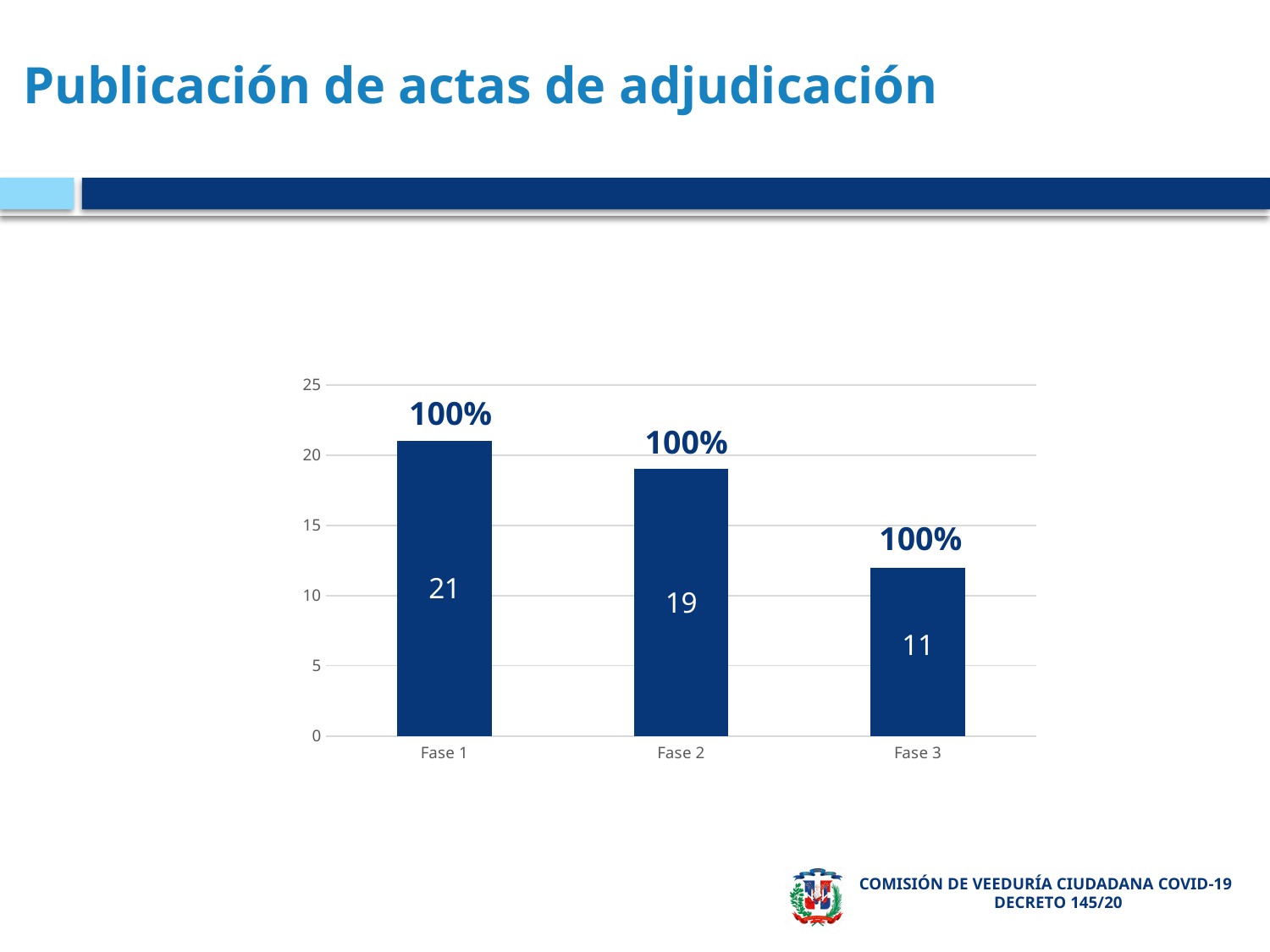
What is the difference between the values for Fase 1 and Fase 2? 2 What is the value for Fase 3? 11 How many categories are shown on the x axis? 3 What is the value for Fase 1? 21 What is the difference between the values for Fase 1 and Fase 3? 10 What percentage label is printed above each bar? 100% Which category has the lowest value? Fase 3 What kind of chart is shown on the slide? bar chart Which category has the highest value? Fase 1 Which is larger, the value for Fase 2 or the value for Fase 3? Fase 2 Is the value for Fase 3 greater or less than 15? less What is the value for Fase 2? 19